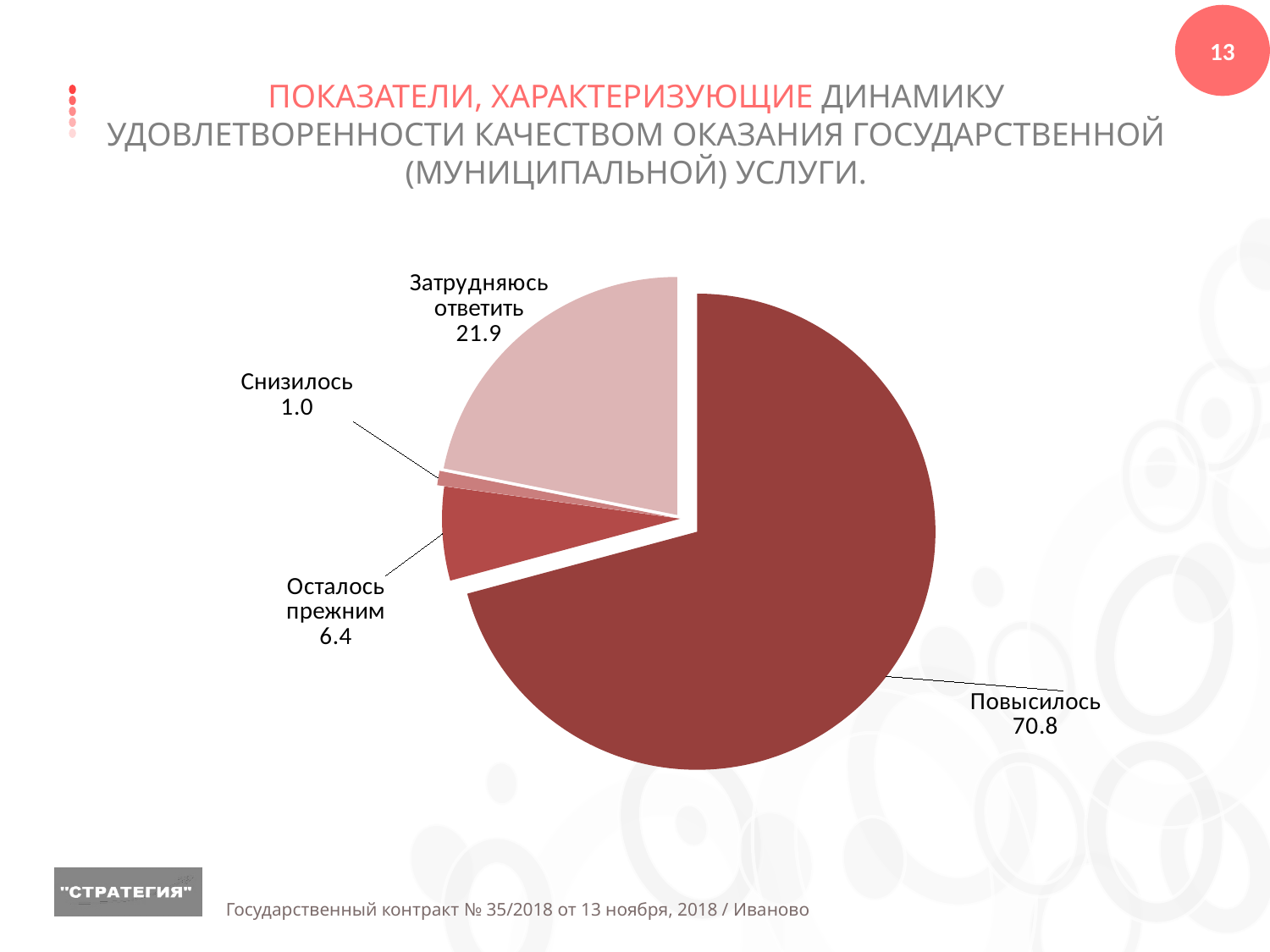
What kind of chart is shown on the slide? pie chart What is the value for «Затрудняюсь ответить»? 21.9 What is the value for «Снизилось»? 1.0 How many slices does the pie chart have? 4 What is the difference between the values for «Повысилось» and «Затрудняюсь ответить»? 48.9 Which is larger, the value for «Затрудняюсь ответить» or the value for «Осталось прежним»? Затрудняюсь ответить Which slice of the pie is the lightest in colour? Затрудняюсь ответить What is the value for «Повысилось»? 70.8 Which category has the smallest slice of the pie? Снизилось What is the value for «Осталось прежним»? 6.4 What is the difference between the values for «Осталось прежним» and «Снизилось»? 5.4 Which category has the largest slice of the pie? Повысилось